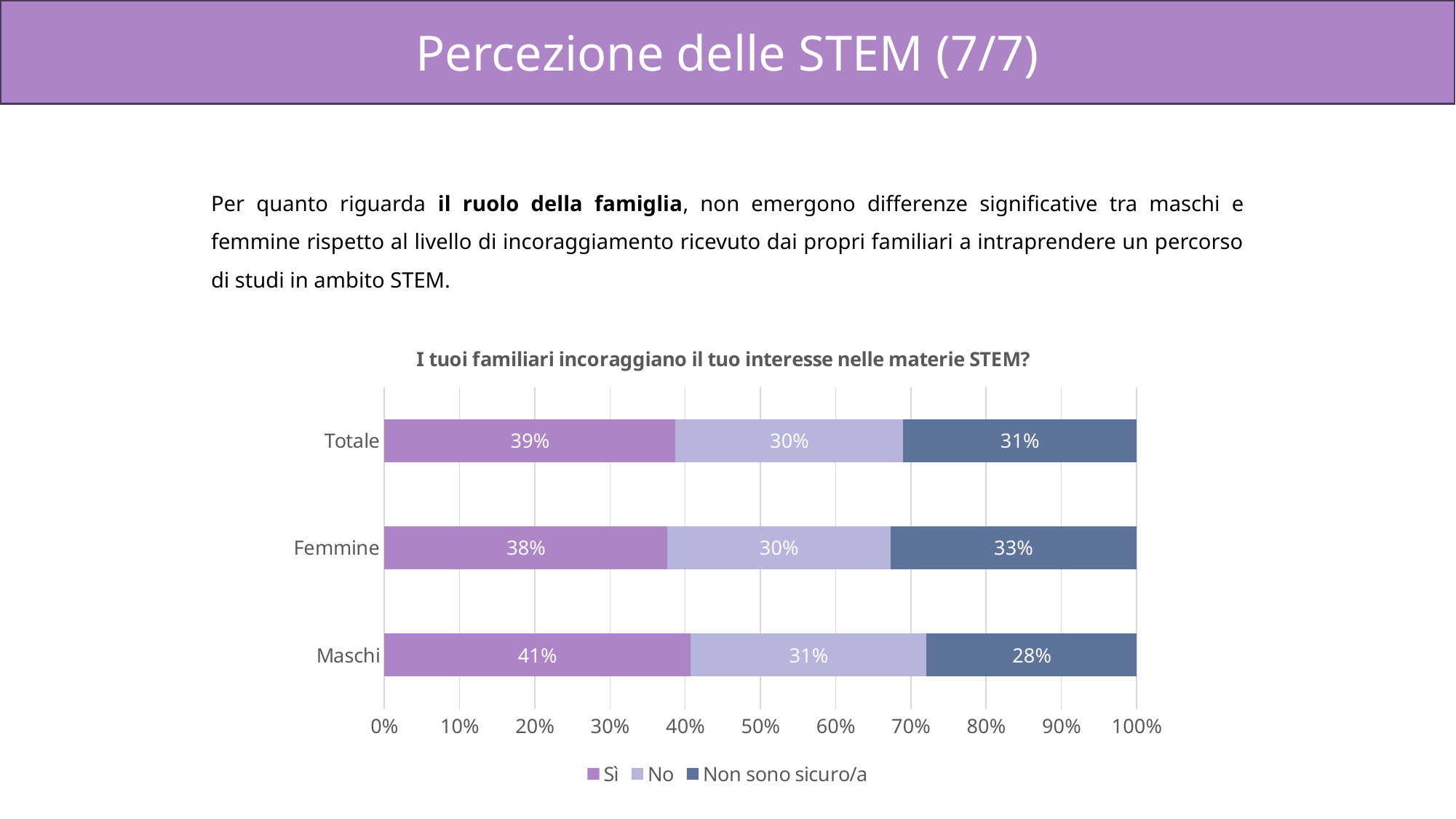
What is the 'Non sono sicuro/a' value for Femmine? 33% What is the 'No' value for Totale? 30% What kind of chart is shown? Stacked bar chart How many series does the legend list? 3 What is the total of the stacked bar for Totale? 100% How many categories are shown on the y axis? 3 What is the title of the chart? I tuoi familiari incoraggiano il tuo interesse nelle materie STEM? Which category has the highest 'Sì' value? Maschi Which is larger: the 'Non sono sicuro/a' value for Femmine or for Maschi? Femmine What is the difference between the 'Sì' values for Maschi and Femmine? 3% What is the 'Sì' value for Maschi? 41% Which category has the lowest 'Non sono sicuro/a' value? Maschi